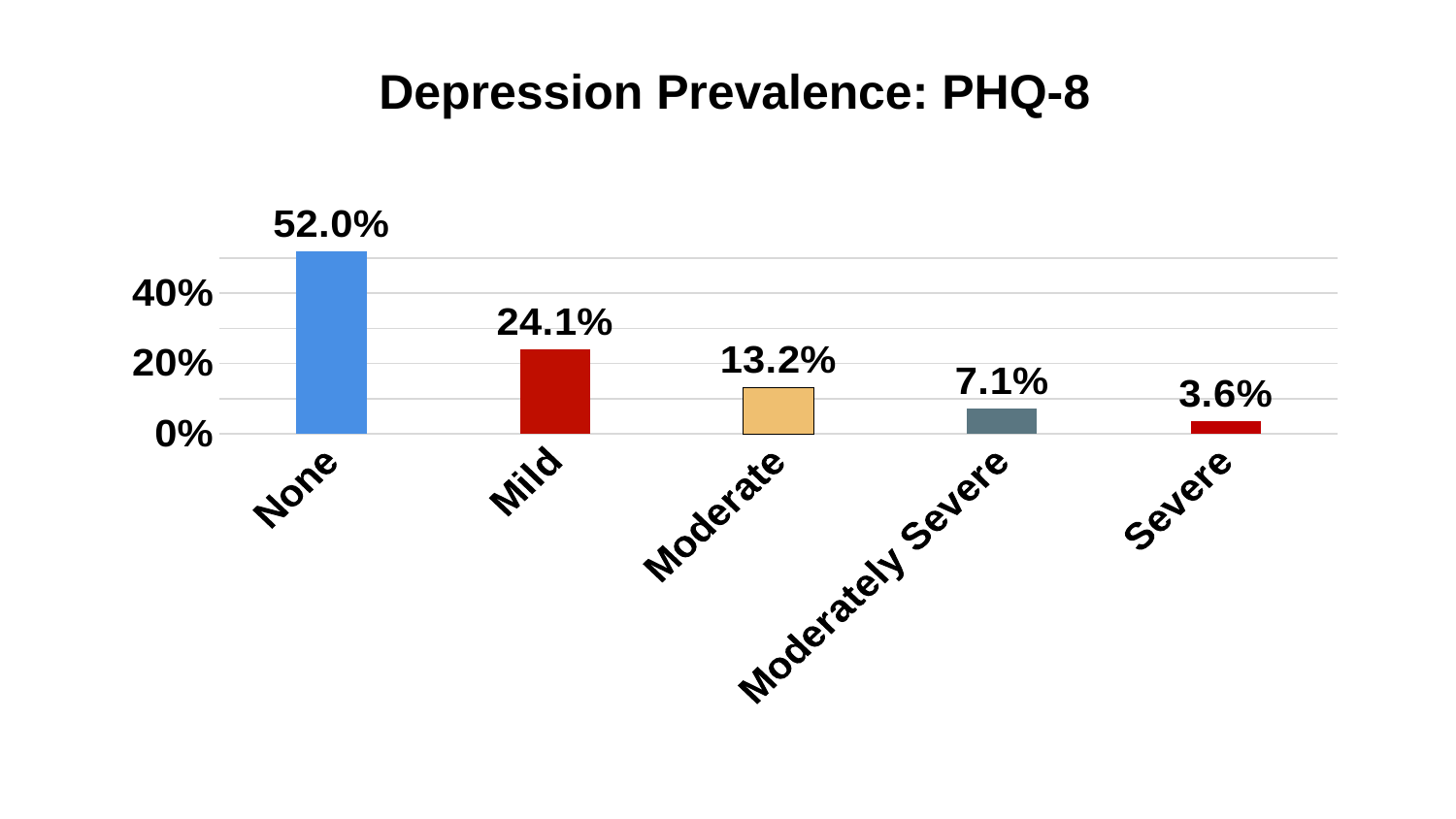
What is the title of the chart? Depression Prevalence: PHQ-8 How many categories are shown on the x axis? 5 Which category has the lowest value? Severe What is the value for None? 52.0% What is the difference between the values for None and Mild? 27.9% Which is larger, the value for Moderate or the value for Severe? Moderate What is the value for Severe? 3.6% What is the value for Moderately Severe? 7.1% What kind of chart is this? Bar chart What is the value for Mild? 24.1% Which category has the highest value? None What is the difference between the values for Moderate and Moderately Severe? 6.1%